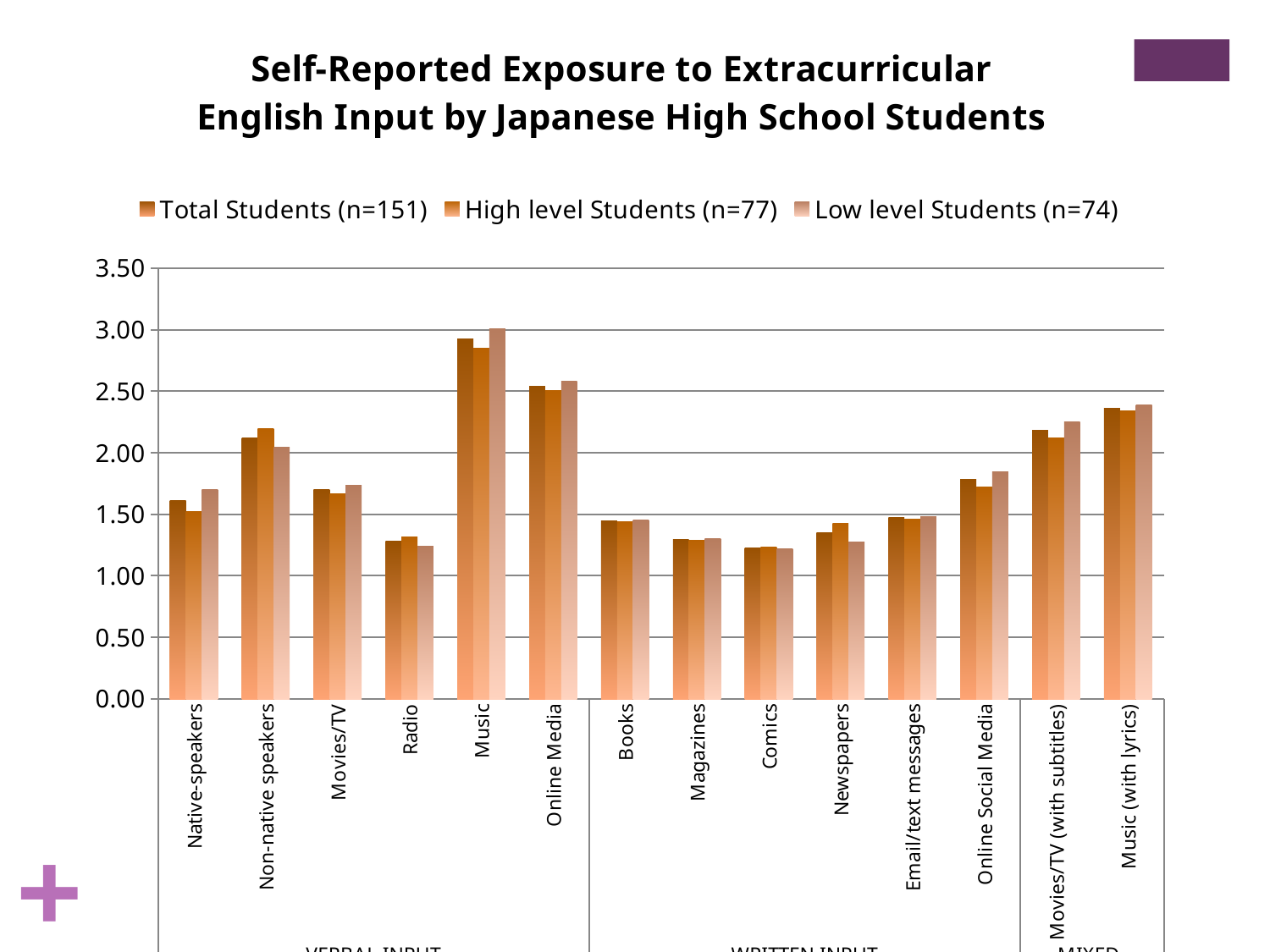
Is the Total Students (n=151) value for Non-native speakers greater or less than 2.00? greater Is the Total Students (n=151) value for Music greater or less than 2.50? greater How many series does the legend list? 3 Is the Low level Students (n=74) value for Online Social Media greater or less than 1.50? greater For Newspapers, which is larger: High level Students (n=77) or Low level Students (n=74)? High level Students (n=77) What is the sample size shown in the legend for High level Students? n=77 What kind of chart is shown on the slide? bar chart Which category has the highest value for Total Students (n=151)? Music For Total Students (n=151), which is larger: Music or Online Media? Music How many categories are plotted along the x axis? 14 For Native-speakers, which is larger: High level Students (n=77) or Low level Students (n=74)? Low level Students (n=74)